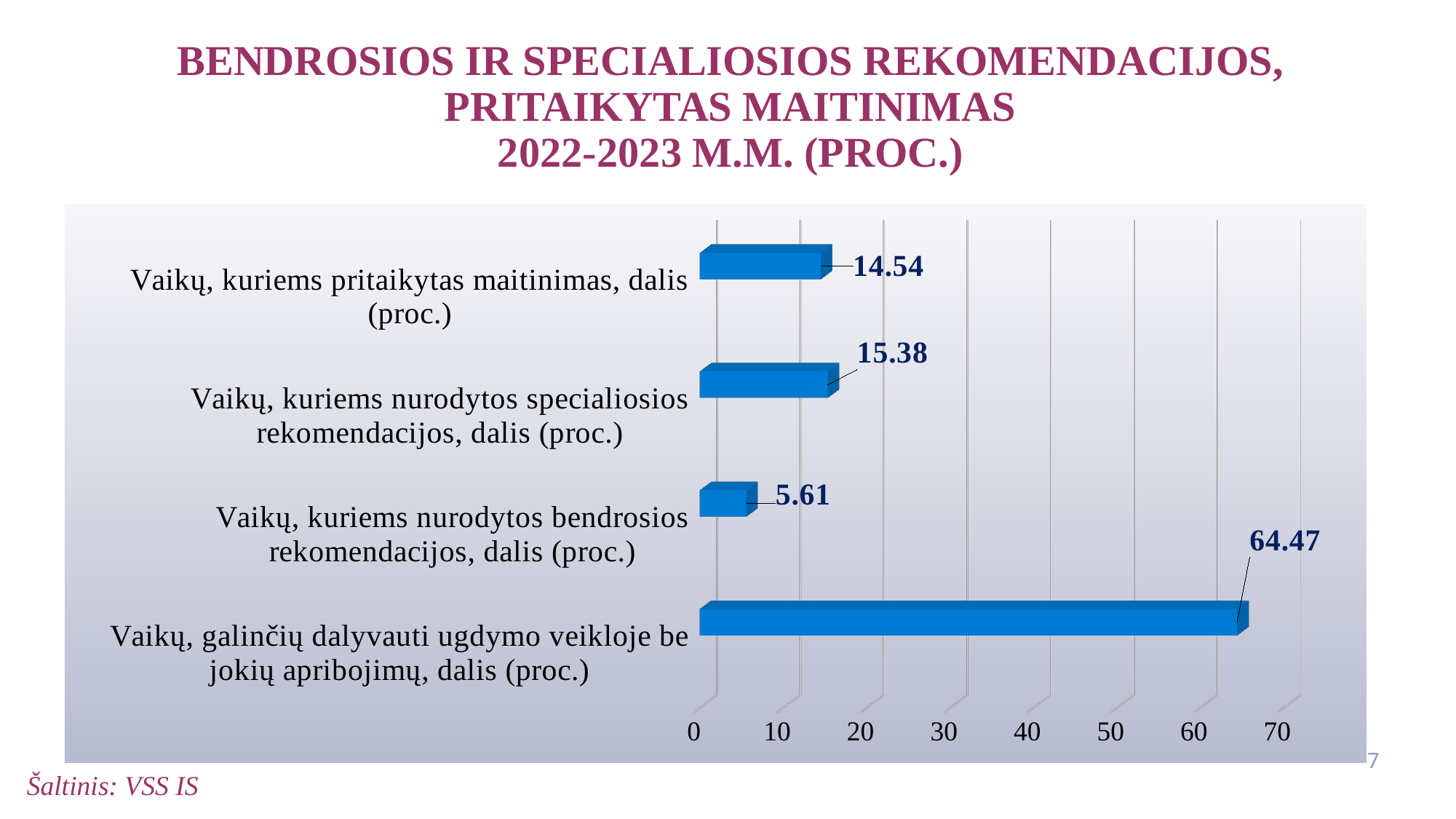
What is the value for 'Vaikų, kuriems pritaikytas maitinimas, dalis (proc.)'? 14.54 What is the value for 'Vaikų, kuriems nurodytos specialiosios rekomendacijos, dalis (proc.)'? 15.38 What is the source cited below the chart? VSS IS What kind of chart is shown on the slide? bar chart Which category has the lowest value? Vaikų, kuriems nurodytos bendrosios rekomendacijos, dalis (proc.) What is the value for 'Vaikų, galinčių dalyvauti ugdymo veikloje be jokių apribojimų, dalis (proc.)'? 64.47 What is the value for 'Vaikų, kuriems nurodytos bendrosios rekomendacijos, dalis (proc.)'? 5.61 What is the difference between the value for 'Vaikų, kuriems nurodytos specialiosios rekomendacijos, dalis (proc.)' and the value for 'Vaikų, kuriems nurodytos bendrosios rekomendacijos, dalis (proc.)'? 9.77 Is the value for 'Vaikų, galinčių dalyvauti ugdymo veikloje be jokių apribojimų, dalis (proc.)' greater or less than 60? greater How many categories are shown in the chart? 4 Which is larger: the value for 'Vaikų, kuriems pritaikytas maitinimas, dalis (proc.)' or the value for 'Vaikų, kuriems nurodytos bendrosios rekomendacijos, dalis (proc.)'? Vaikų, kuriems pritaikytas maitinimas, dalis (proc.) Which category has the highest value? Vaikų, galinčių dalyvauti ugdymo veikloje be jokių apribojimų, dalis (proc.)